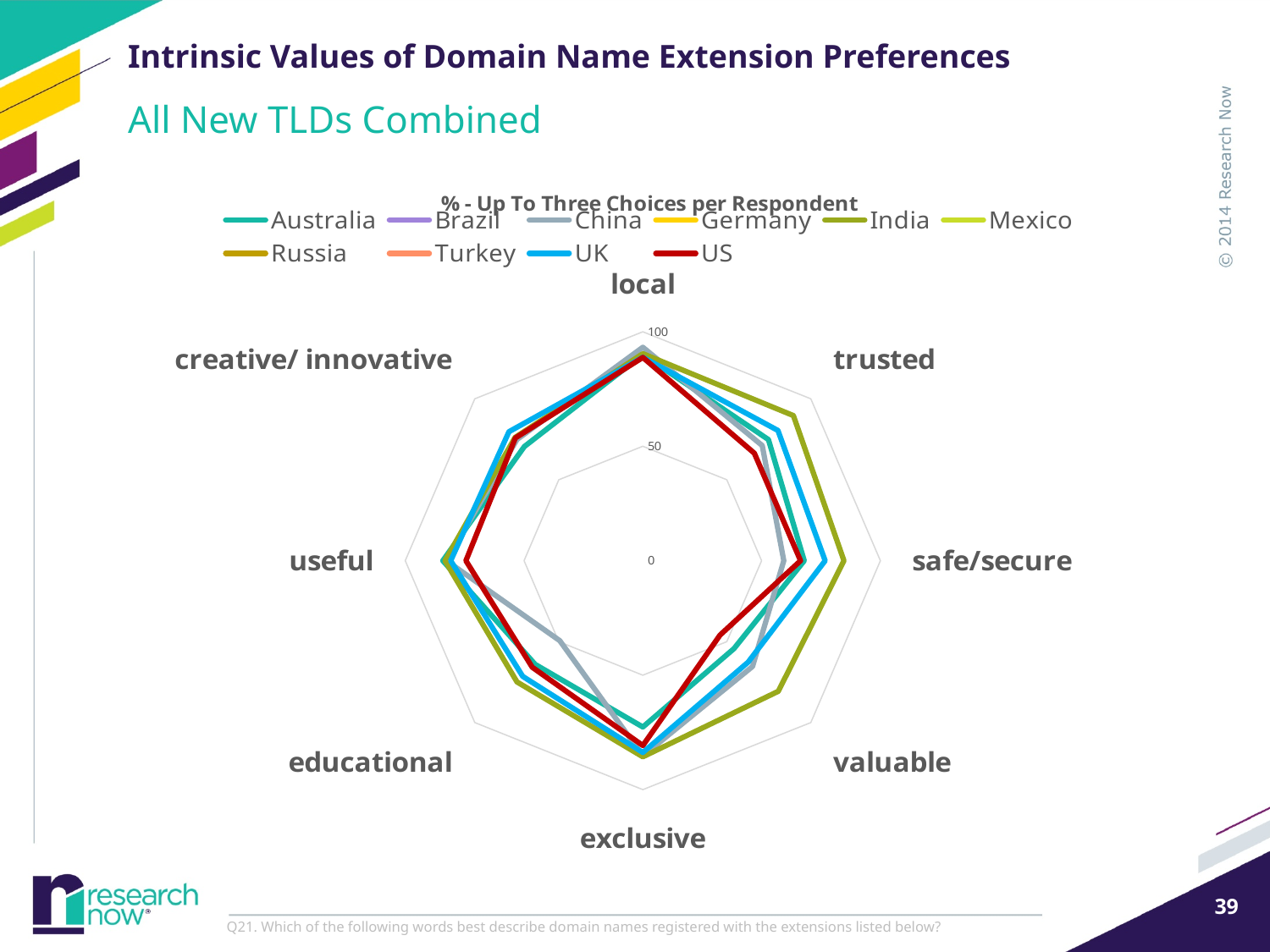
Is the value for US on the 'exclusive' axis greater or less than 50? greater Is the value for US on the 'useful' axis greater or less than 50? greater How many series does the legend list? 10 What kind of chart is shown on the slide? radar chart What is the title of the chart? % - Up To Three Choices per Respondent Is the value for UK on the 'safe/secure' axis greater or less than 100? less Which category is plotted at the top of the radar chart? local What is the maximum value shown on the radar chart's axis scale? 100 How many categories (axes) does the radar chart have? 8